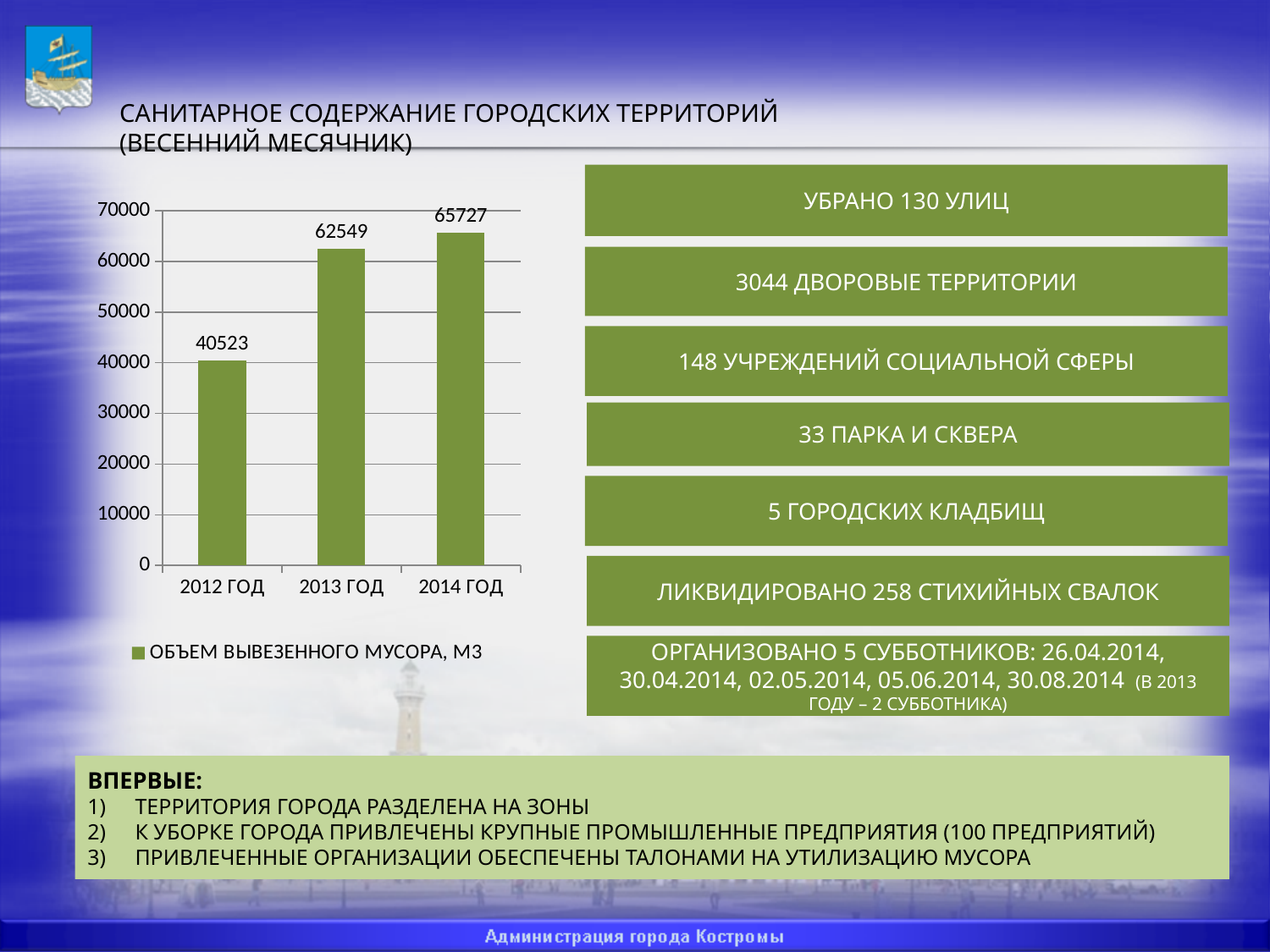
What series name does the legend show? ОБЪЕМ ВЫВЕЗЕННОГО МУСОРА, М3 Is the value for 2012 ГОД greater or less than 50000? less What is the value for 2012 ГОД? 40523 What kind of chart is shown? bar chart Which year has the highest value? 2014 ГОД What is the value for 2014 ГОД? 65727 What is the difference between the values for 2013 ГОД and 2012 ГОД? 22026 Which is larger, the value for 2012 ГОД or 2013 ГОД? 2013 ГОД What is the difference between the values for 2014 ГОД and 2013 ГОД? 3178 Which year has the lowest value? 2012 ГОД How many categories are shown on the x axis? 3 What is the value for 2013 ГОД? 62549